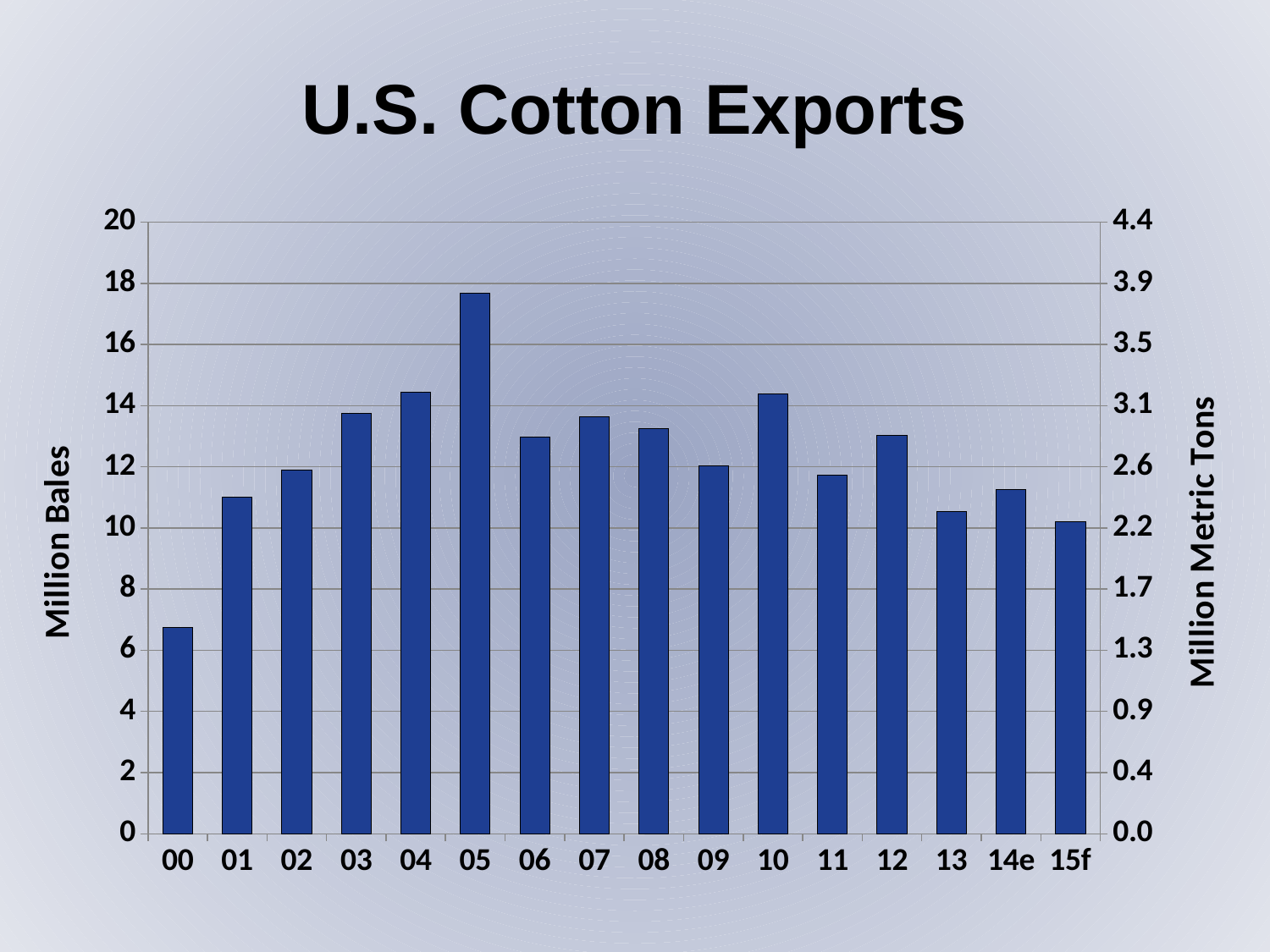
Which year has higher exports, 09 or 10? 10 Is the value for 15f greater or less than 12 million bales? less Which year has the lowest cotton exports? 00 How many years (categories) are shown on the x axis? 16 What is the title of the chart? U.S. Cotton Exports What kind of chart is shown on the slide? bar chart What is the label on the left vertical axis? Million Bales Which year has higher exports, 04 or 05? 05 Is the value for 00 greater or less than 8 million bales? less Which year has the highest cotton exports? 05 Is the value for 05 greater or less than 16 million bales? greater